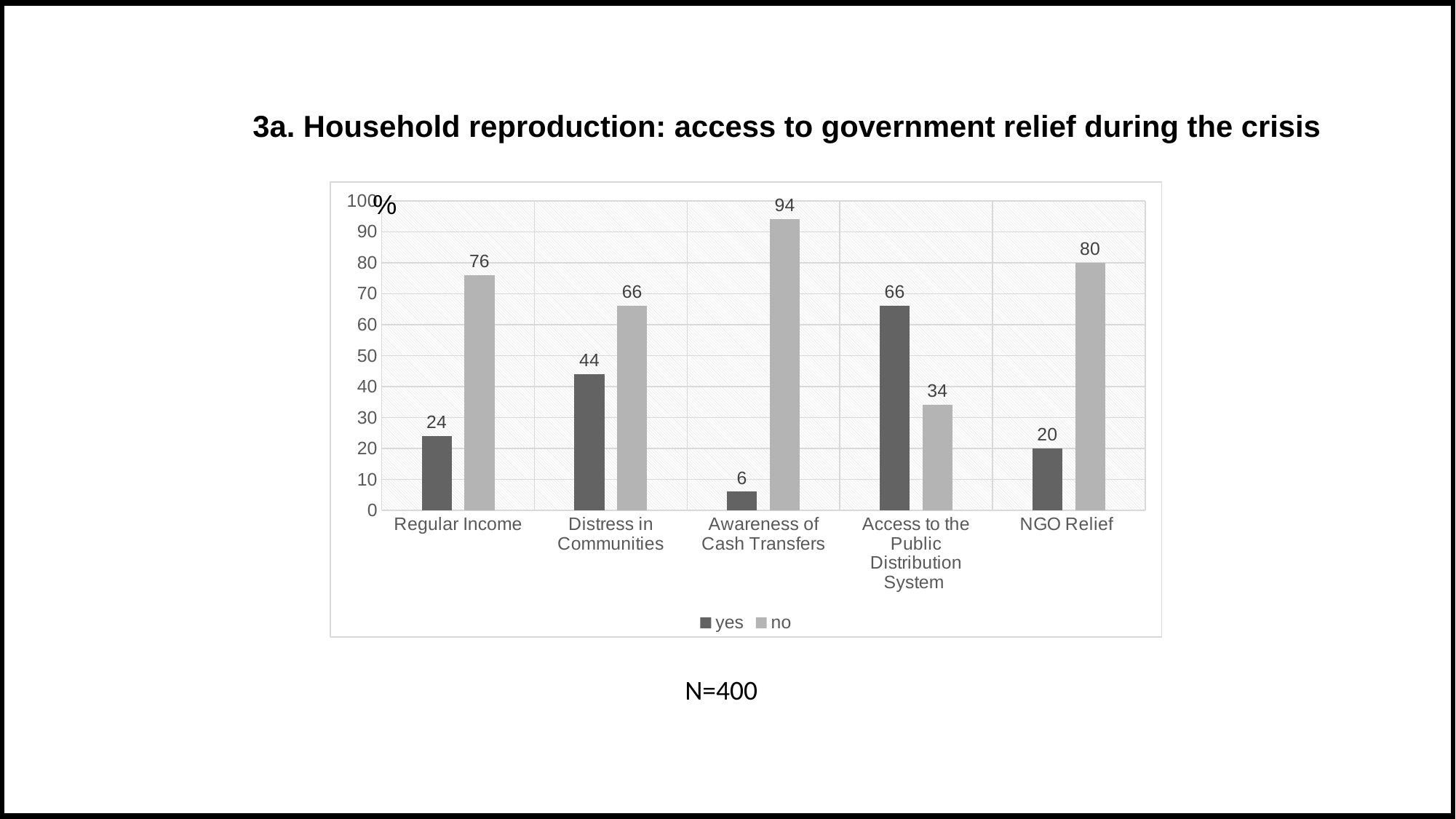
Which category has the lowest 'yes' value? Awareness of Cash Transfers How many categories are shown on the x axis? 5 What is the 'no' value for NGO Relief? 80 What kind of chart is shown on the slide? bar chart What sample size is stated below the chart? N=400 What is the 'no' value for Awareness of Cash Transfers? 94 What is the 'yes' value for Access to the Public Distribution System? 66 How many series does the legend list? 2 Which category has the highest 'yes' value? Access to the Public Distribution System Which is larger for NGO Relief, the 'yes' value or the 'no' value? no What is the 'yes' value for Regular Income? 24 What is the difference between the 'no' and 'yes' values for Distress in Communities? 22